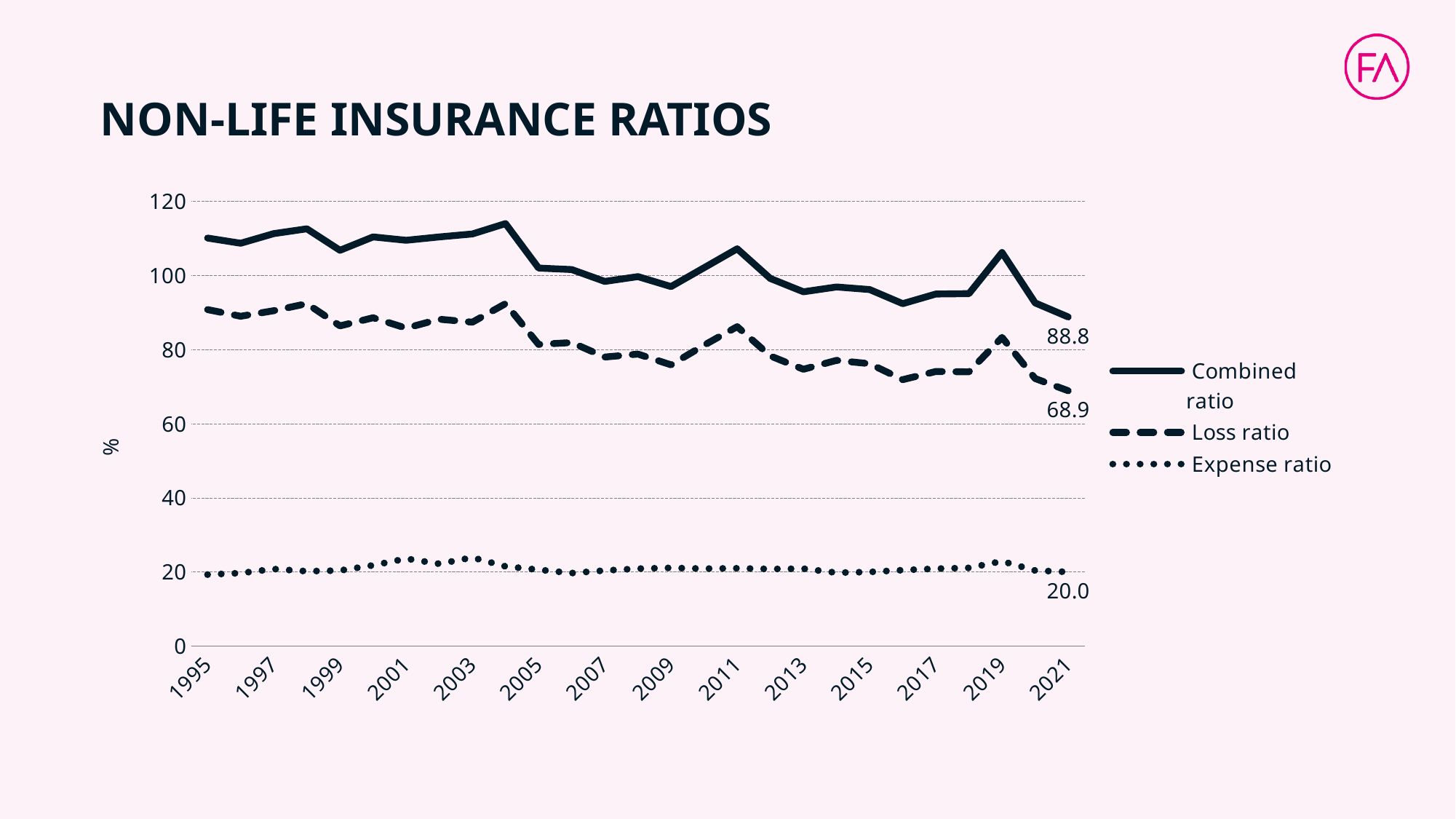
How many series does the legend list? 3 Which series has the highest values across the whole period? Combined ratio Is the Combined ratio in 2004 greater or less than 100? greater What is the Loss ratio value shown for 2021? 68.9 Which series has the lowest values across the whole period? Expense ratio Overall, does the Combined ratio rise or fall from 1995 to 2021? Fall Is the Loss ratio in 2019 greater or less than 80? greater What is the Combined ratio value shown for 2021? 88.8 What kind of chart is shown on the slide? Line chart What is the difference between the Combined ratio and the Loss ratio in 2021? 19.9 What unit is shown on the y-axis label? % What is the Expense ratio value shown for 2021? 20.0